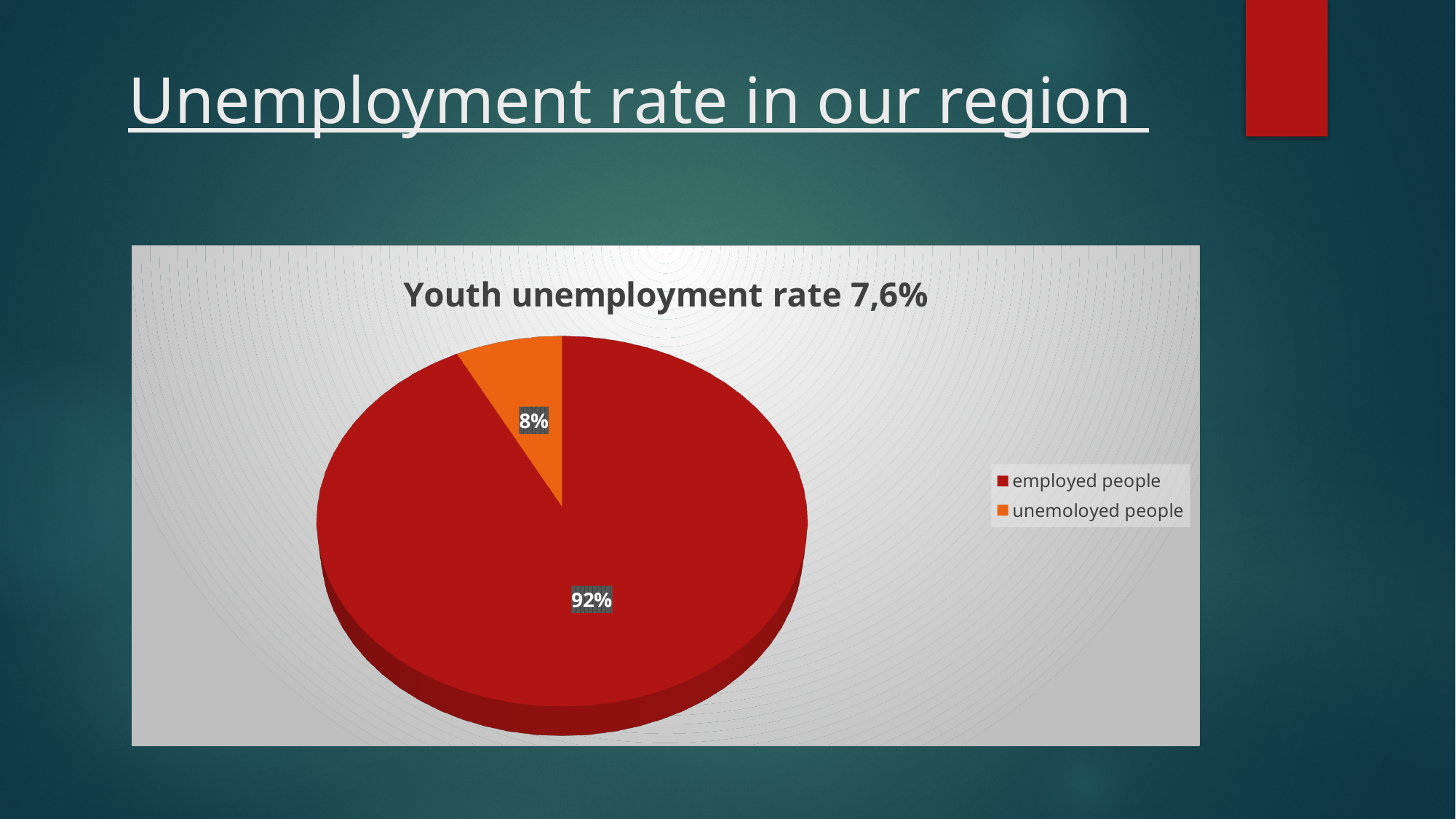
How many entries does the legend list? 2 Which category has the smallest slice of the pie? unemoloyed people What share of the pie is labelled for employed people? 92% How many slices does the pie chart have? 2 What is the title of the chart? Youth unemployment rate 7,6% What colour is the slice for unemoloyed people? orange What share of the pie is labelled for unemoloyed people? 8% Which category has the largest slice of the pie? employed people What kind of chart is shown on the slide? pie chart Which slice is larger, employed people or unemoloyed people? employed people What is the difference in percentage points between the employed people slice and the unemoloyed people slice? 84